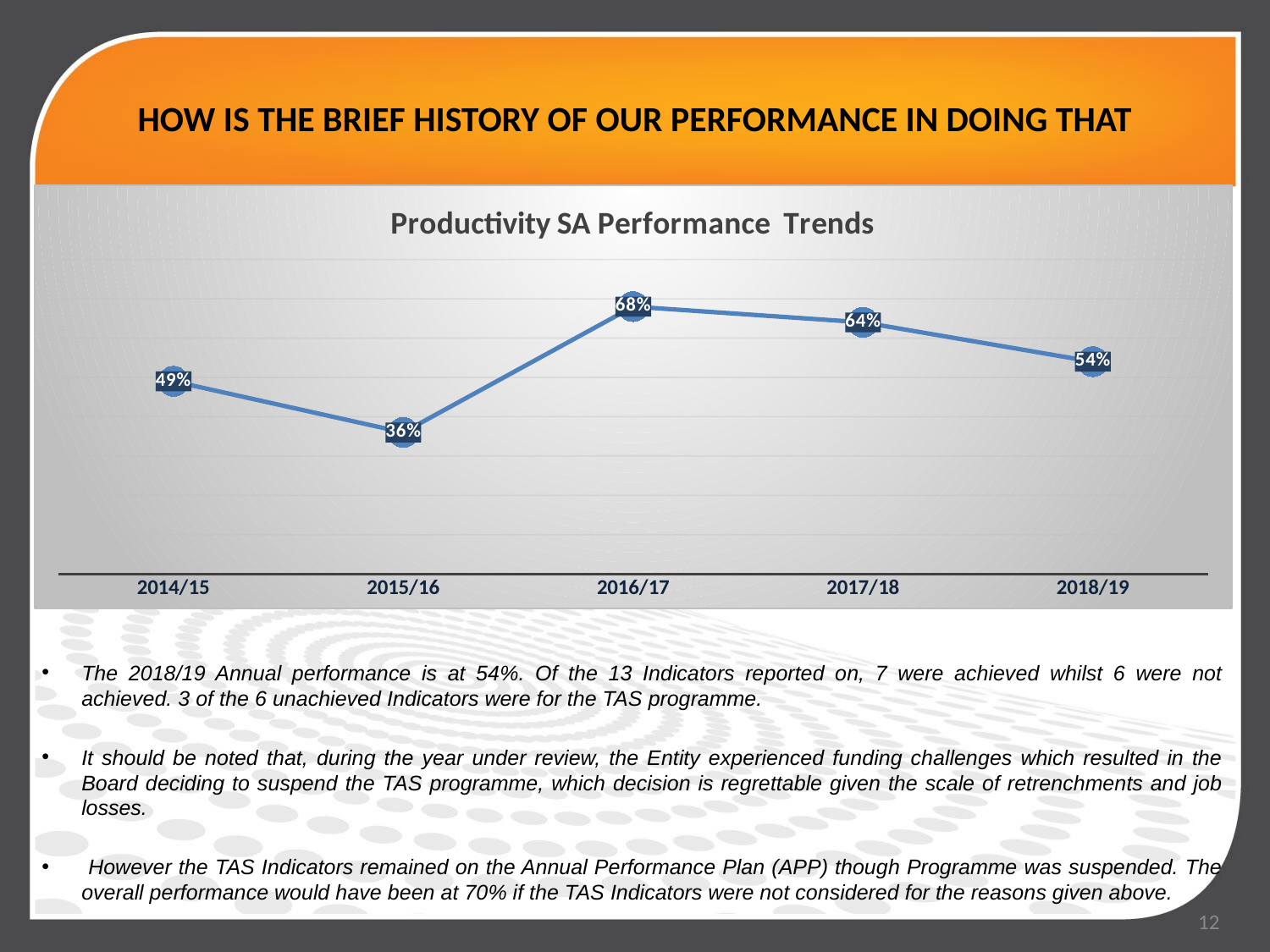
What is the value for 2014/15? 49% What is the title of the chart? Productivity SA Performance Trends What is the value for 2016/17? 68% What kind of chart is shown? line chart Do the values rise or fall from 2016/17 to 2018/19? fall Which year has the highest value? 2016/17 What is the difference between the values for 2017/18 and 2018/19? 10% How many years are plotted on the chart? 5 Which year has the lowest value? 2015/16 What is the difference between the values for 2016/17 and 2015/16? 32% Which is larger, the value for 2014/15 or the value for 2015/16? 2014/15 What is the value for 2018/19? 54%